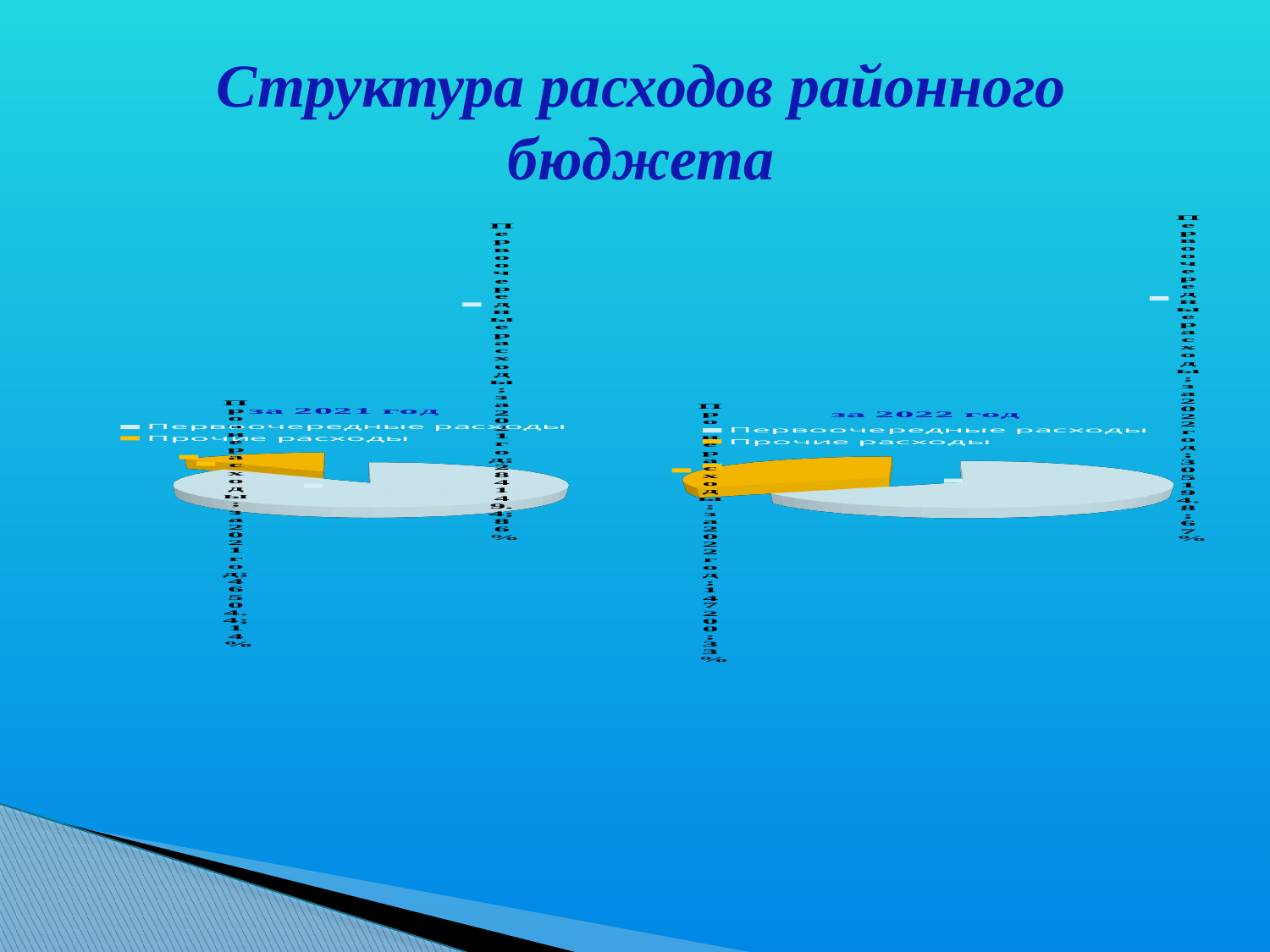
In the chart titled "за 2022 год", which category has the largest slice? Первоочередные расходы What is the title of the right chart on the slide? за 2022 год In the chart titled "за 2022 год", which slice is larger: Первоочередные расходы or Прочие расходы? Первоочередные расходы What kind of chart is the chart titled "за 2022 год"? pie chart In the chart titled "за 2021 год", how many series does the legend list? 2 What kind of chart is the chart titled "за 2021 год"? pie chart In the chart titled "за 2021 год", which category has the smallest slice? Прочие расходы In the chart titled "за 2021 год", which category has the largest slice? Первоочередные расходы In the chart titled "за 2021 год", how many slices does the pie have? 2 In the chart titled "за 2022 год", how many slices does the pie have? 2 What is the title of the left chart on the slide? за 2021 год In the chart titled "за 2022 год", how many series does the legend list? 2